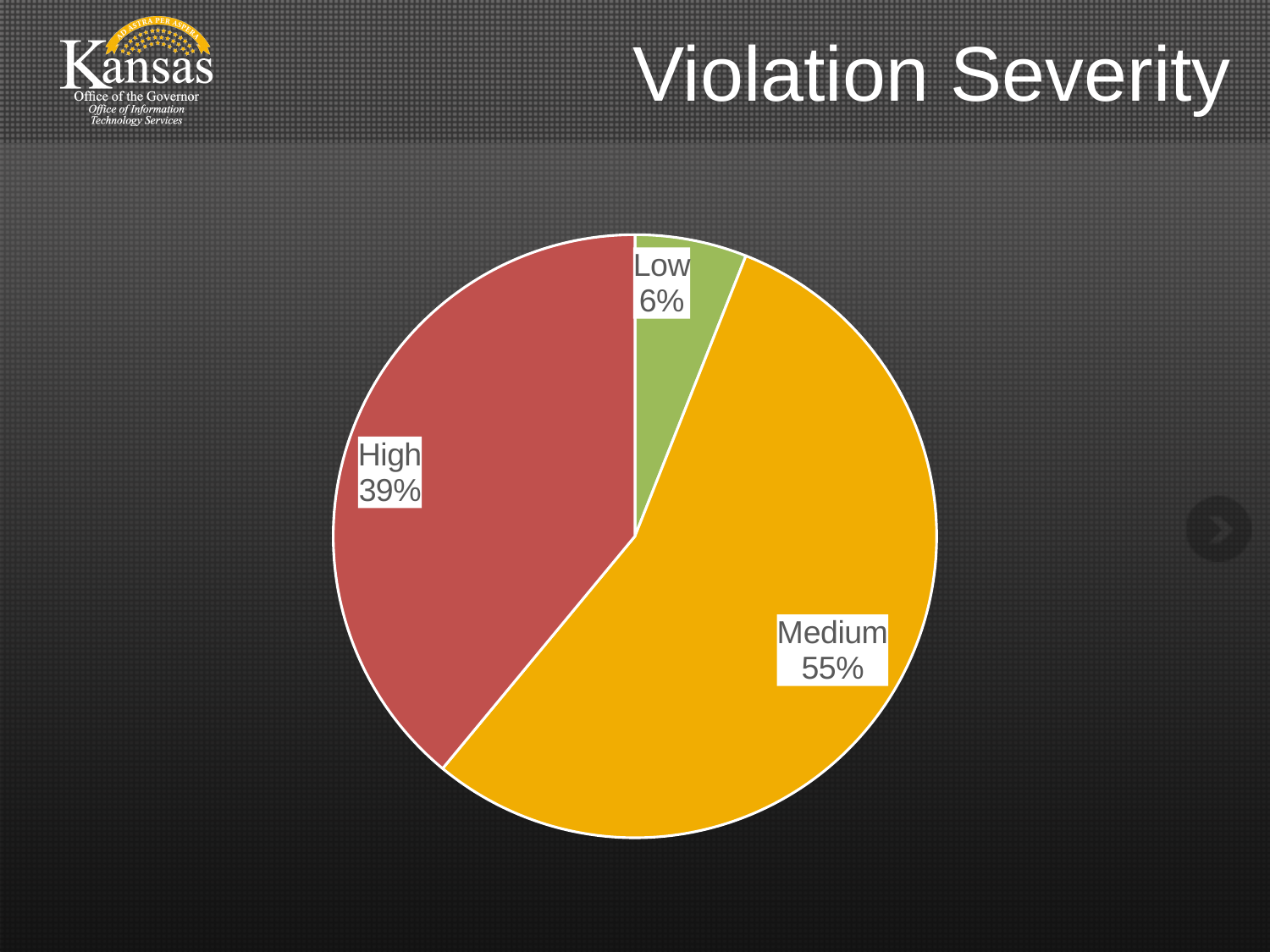
What is the difference in percentage points between the High and Low slices? 33 What kind of chart is shown on the slide? pie chart What is the title of the slide containing the pie chart? Violation Severity Which severity category has the smallest share of the pie? Low Which is larger, the High slice or the Low slice? High What is the difference in percentage points between the Medium and High slices? 16 What percentage of violations are Low severity? 6% What percentage of violations are High severity? 39% What colour is the Medium slice of the pie chart? orange Which severity category has the largest share of the pie? Medium What percentage of violations are Medium severity? 55% How many slices does the pie chart have? 3